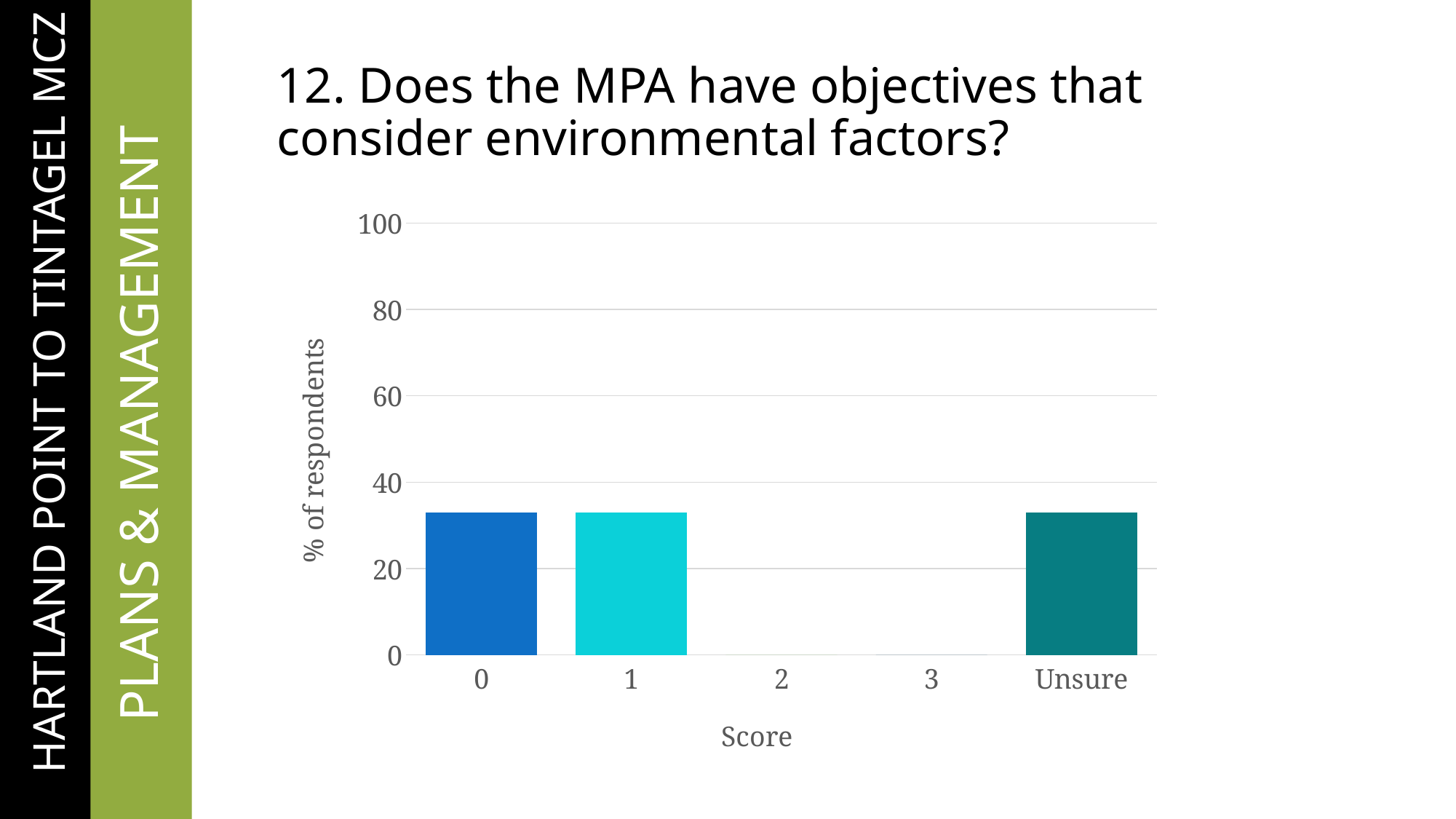
Is the value for score 1 greater or less than 40? less What is the label of the vertical axis? % of respondents Is the value for score 0 greater or less than 20? greater How many score categories have a visible bar above zero? 3 What kind of chart is shown on the slide? bar chart How many score categories are shown on the x axis? 5 Which has the larger value, score 0 or score 2? 0 Which has the larger value, score 3 or Unsure? Unsure Is the value for Unsure greater or less than 20? greater What is the label of the horizontal axis? Score